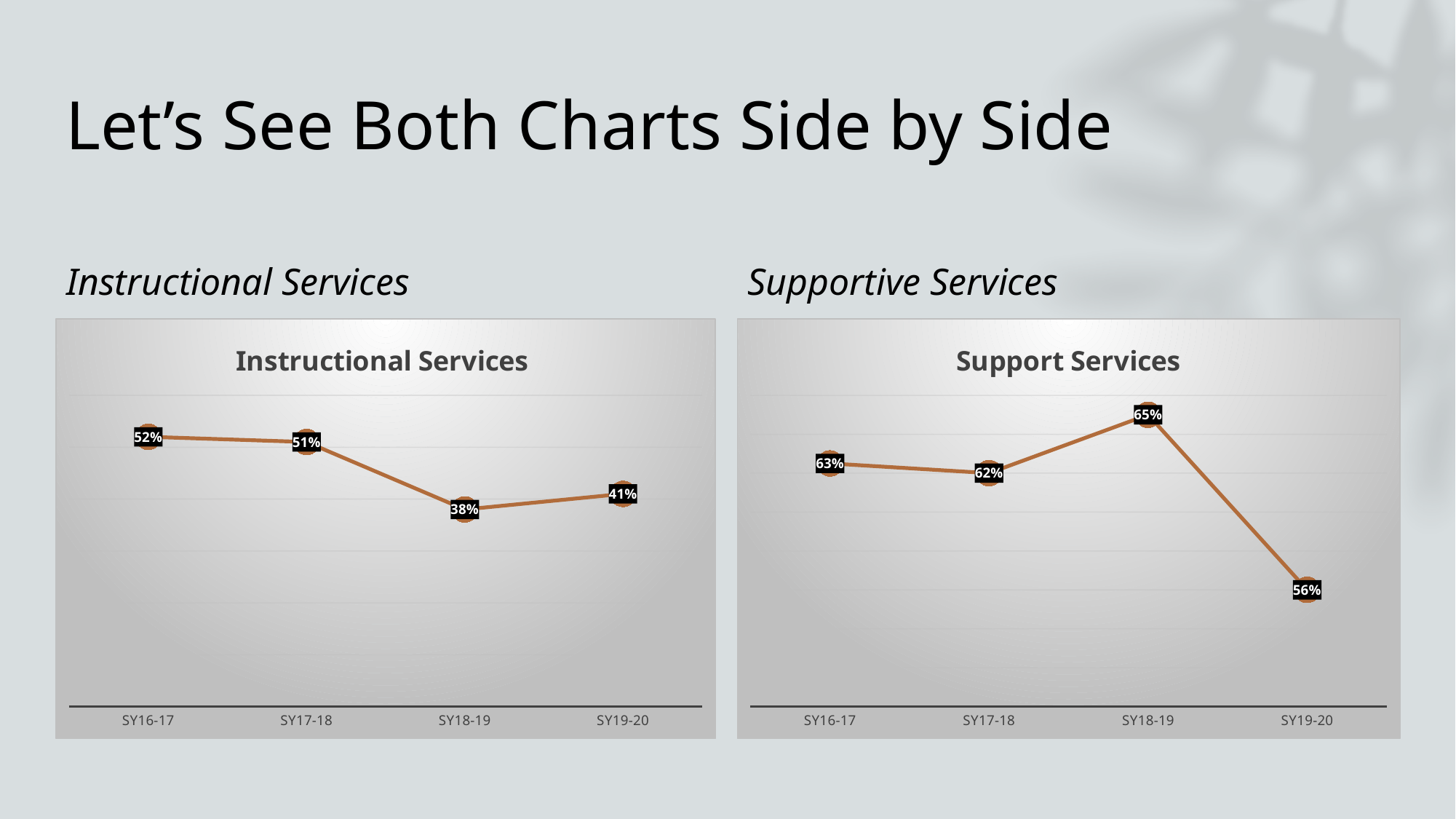
In the Instructional Services chart, which school year has the highest value? SY16-17 In the Support Services chart, what is the value for SY19-20? 56% What kind of chart is the Instructional Services chart? Line chart In the Support Services chart, which school year has the highest value? SY18-19 In the Instructional Services chart, which is larger, the value for SY17-18 or the value for SY19-20? SY17-18 In the Instructional Services chart, which school year has the lowest value? SY18-19 In the Instructional Services chart, do the values rise or fall from SY16-17 to SY18-19? Fall How many school years are plotted in the Support Services chart? 4 In the Instructional Services chart, what is the difference between the SY16-17 value and the SY18-19 value? 14% In the Support Services chart, what is the difference between the SY18-19 value and the SY19-20 value? 9% In the Support Services chart, which school year has the lowest value? SY19-20 In the Instructional Services chart, what is the value for SY18-19? 38%